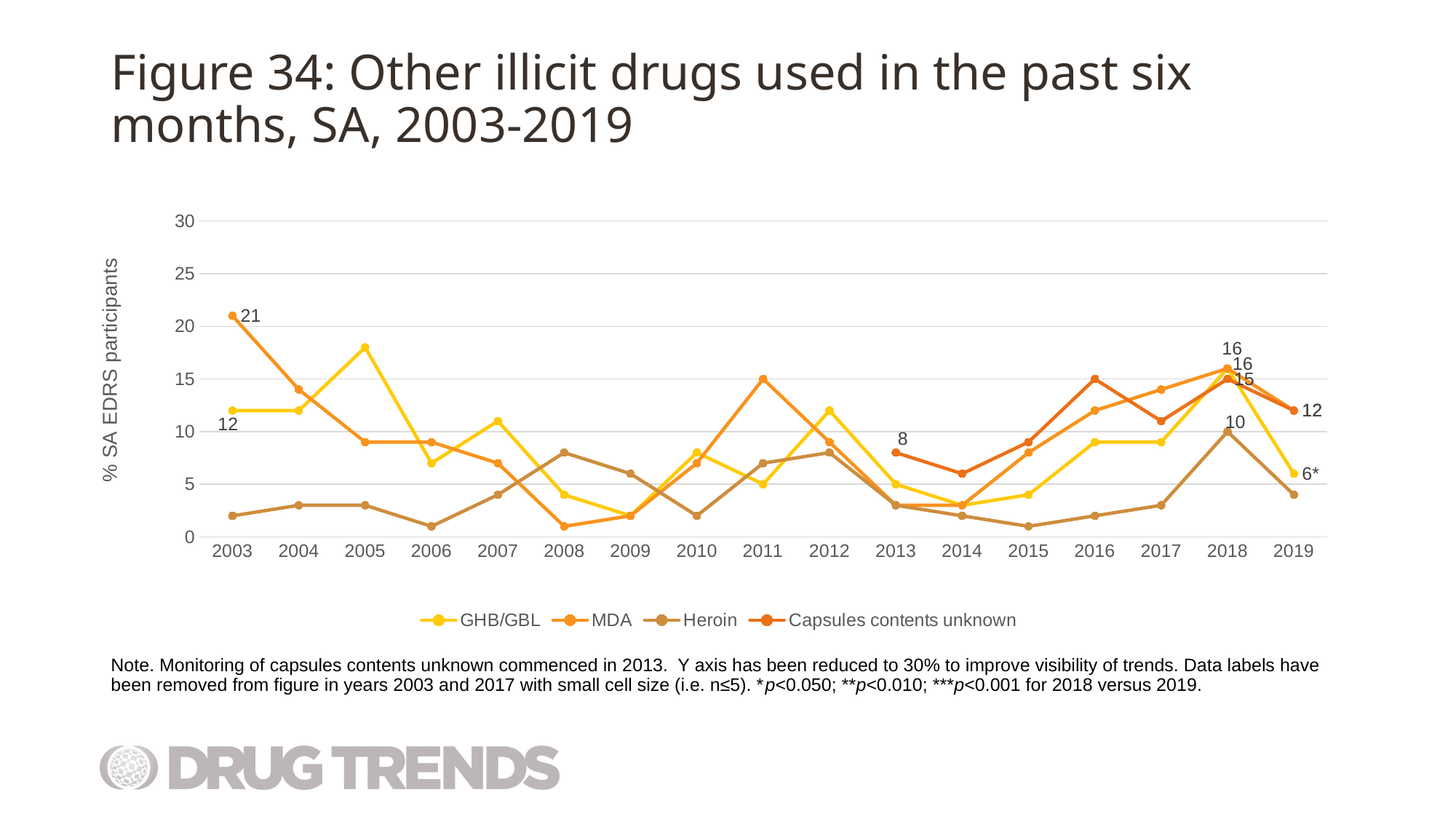
What is the difference between the MDA and GHB/GBL values in 2003? 9 How many years are shown on the x axis? 17 What is the label on the y axis? % SA EDRS participants What is the value for MDA in 2003? 21 Which series has the highest value in 2003? MDA How many series does the legend list? 4 Is the value for GHB/GBL in 2005 greater or less than 15? greater What is the value for GHB/GBL in 2003? 12 What is the value for Capsules contents unknown in 2013? 8 What is the value for Heroin in 2018? 10 What is the data label shown for GHB/GBL in 2019? 6* What kind of chart is shown on the slide? line chart